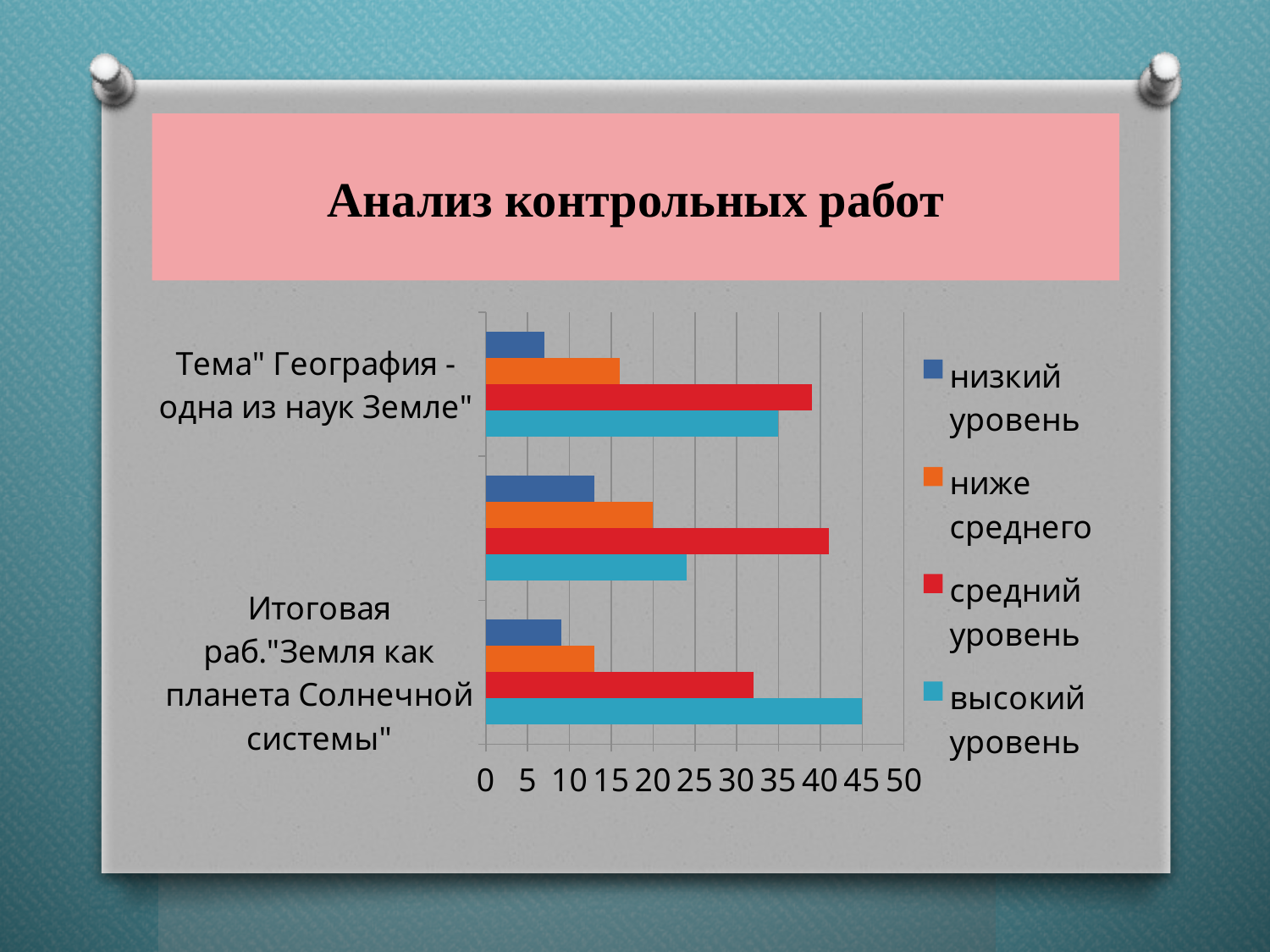
For "Итоговая раб."Земля как планета Солнечной системы"", which level has the highest value? высокий уровень How many groups of bars are plotted on the chart? 3 For "Тема" География - одна из наук Земле"", is the value for ниже среднего greater or less than 20? less For "Тема" География - одна из наук Земле"", is the value for средний уровень greater or less than 35? greater For "Итоговая раб."Земля как планета Солнечной системы"", is the value for высокий уровень greater or less than 40? greater For "Тема" География - одна из наук Земле"", which is larger: средний уровень or высокий уровень? средний уровень How many series does the legend list? 4 For "Итоговая раб."Земля как планета Солнечной системы"", which is larger: высокий уровень or средний уровень? высокий уровень What kind of chart is shown on the slide? bar chart For "Тема" География - одна из наук Земле"", which level has the lowest value? низкий уровень